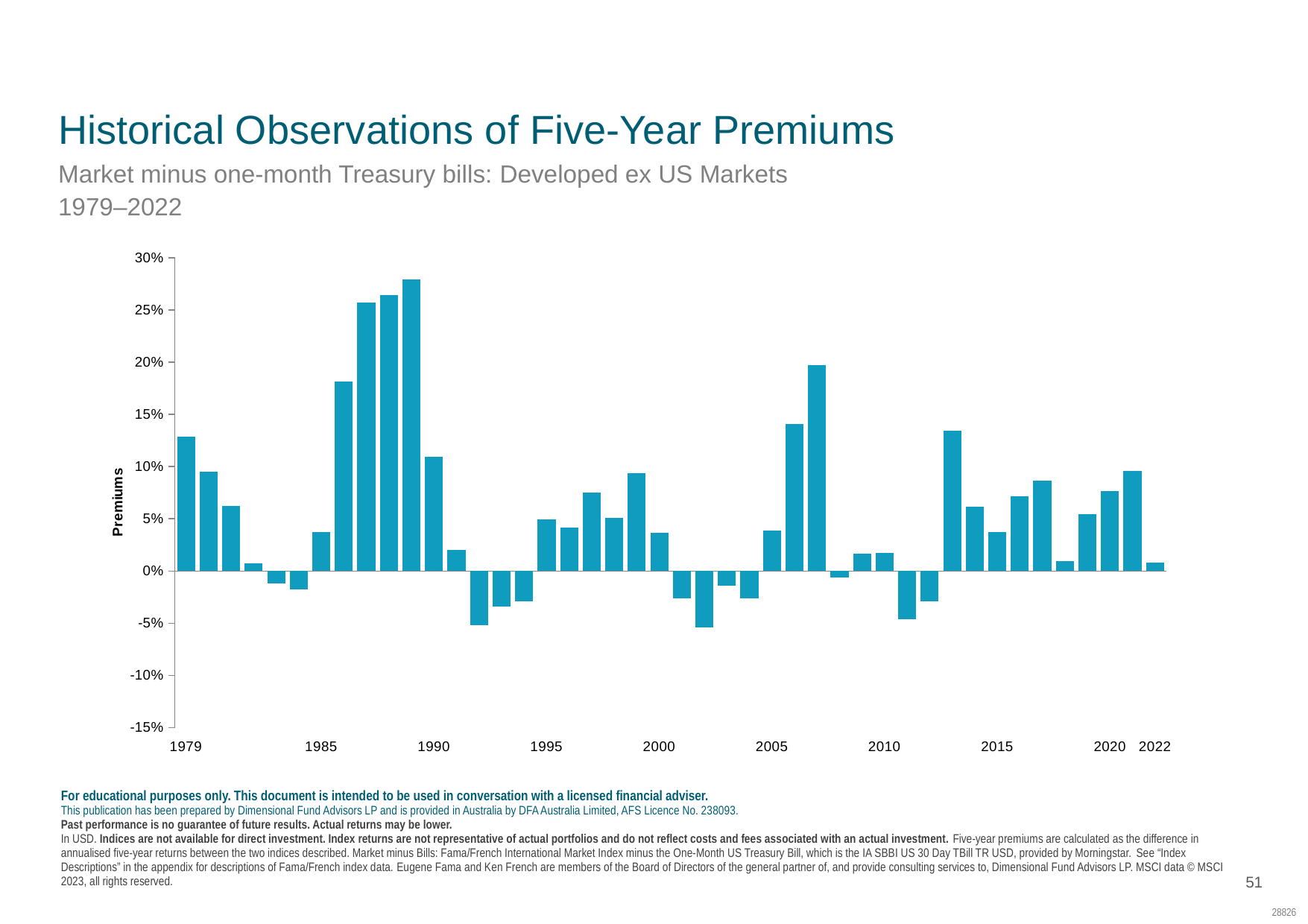
Is the value for 2005 greater or less than 5%? less What is the label on the vertical axis of the chart? Premiums Is the value for 1990 greater or less than 10%? greater Which year has the highest five-year premium in the chart? 1989 What is the first year shown on the horizontal axis of the chart? 1979 Is the value for 1985 greater or less than 5%? less Do the values rise or fall from 1985 to 1989? rise What kind of chart is shown on the slide? Bar chart Which is larger, the value for 2020 or the value for 2022? 2020